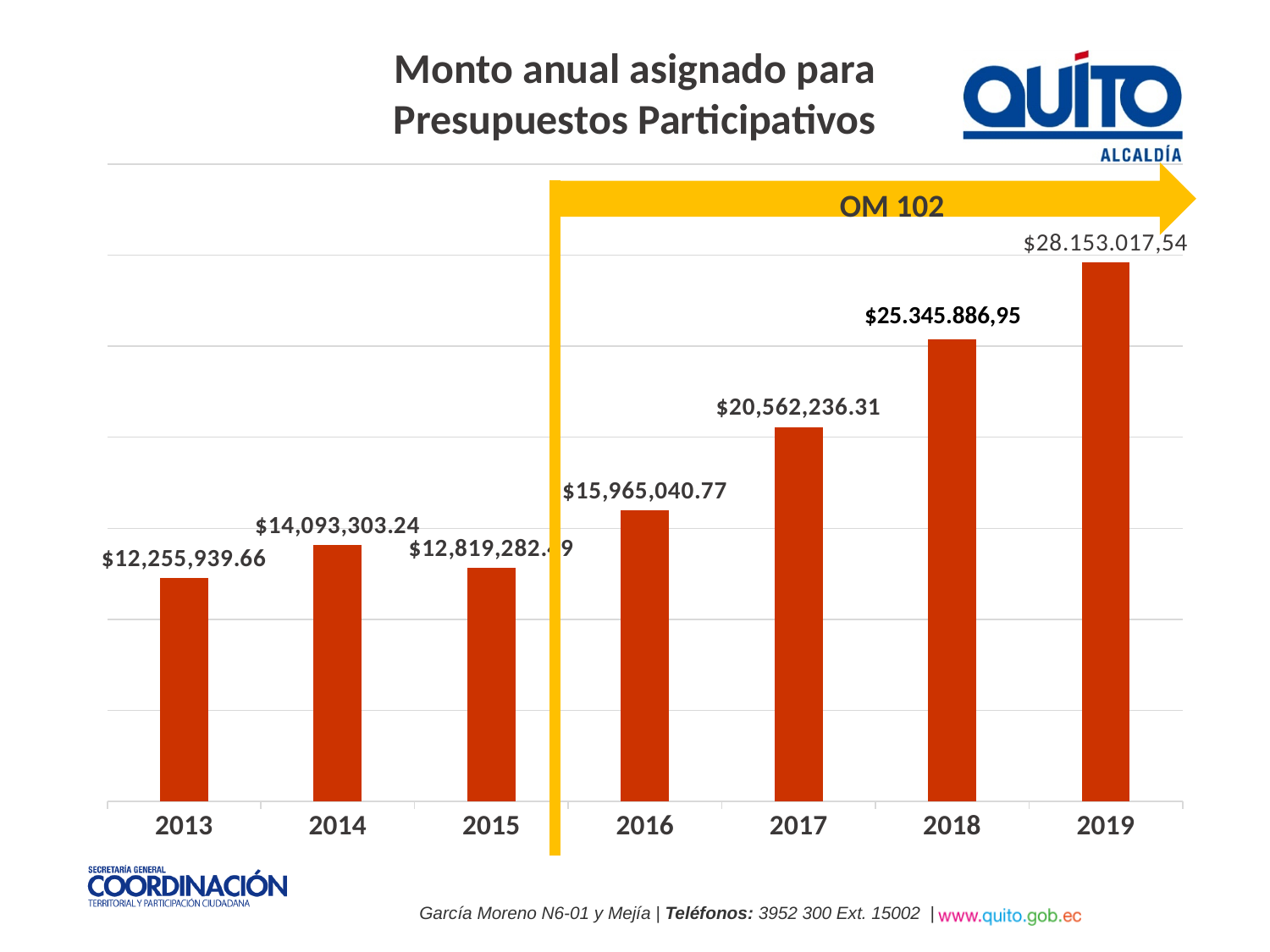
What is the value for 2019? $28.153.017,54 What is the value for 2014? $14,093,303.24 What is the value for 2016? $15,965,040.77 Which year has the highest value? 2019 What is the title of the chart? Monto anual asignado para Presupuestos Participativos What type of chart is shown on the slide? Bar chart Which is larger, the value for 2014 or the value for 2015? 2014 What is the difference between the values for 2017 and 2016? $4,597,195.54 What is the value for 2017? $20,562,236.31 Which year has the lowest value? 2013 What is the value for 2013? $12,255,939.66 How many years are shown on the x axis of the chart? 7